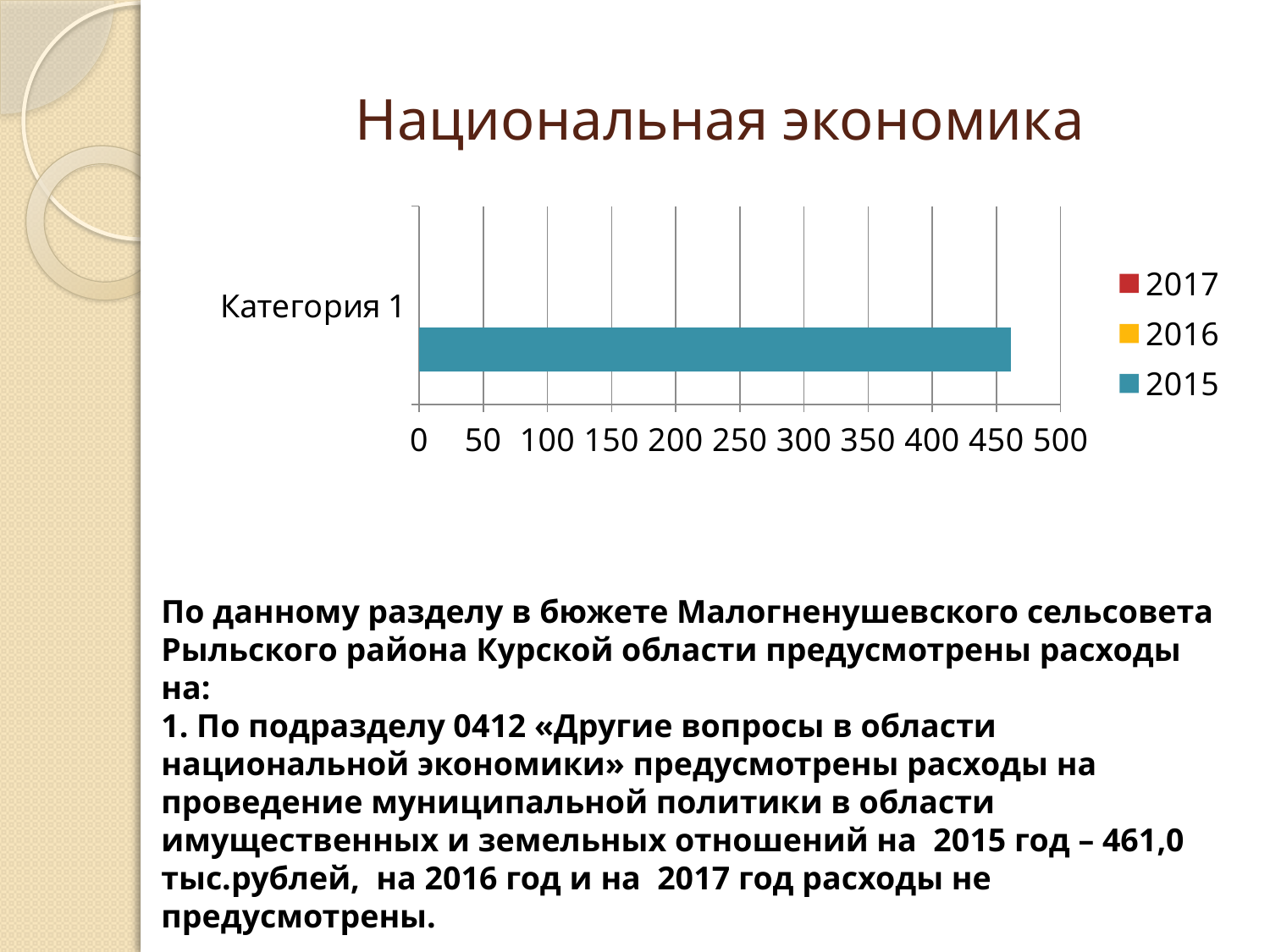
Which years are listed in the chart legend? 2017, 2016, 2015 What kind of chart is shown on the slide? bar chart What is the label of the category on the chart's vertical axis? Категория 1 How many series does the chart legend list? 3 How many categories are shown on the chart's vertical axis? 1 Which series has a visible bar for Категория 1? 2015 What is the highest tick value shown on the chart's horizontal axis? 500 What is the title of the slide containing the chart? Национальная экономика Is the value of the 2015 bar for Категория 1 greater or less than 500? less Is the value of the 2015 bar for Категория 1 greater or less than 400? greater Is the value of the 2015 bar for Категория 1 greater or less than 450? greater